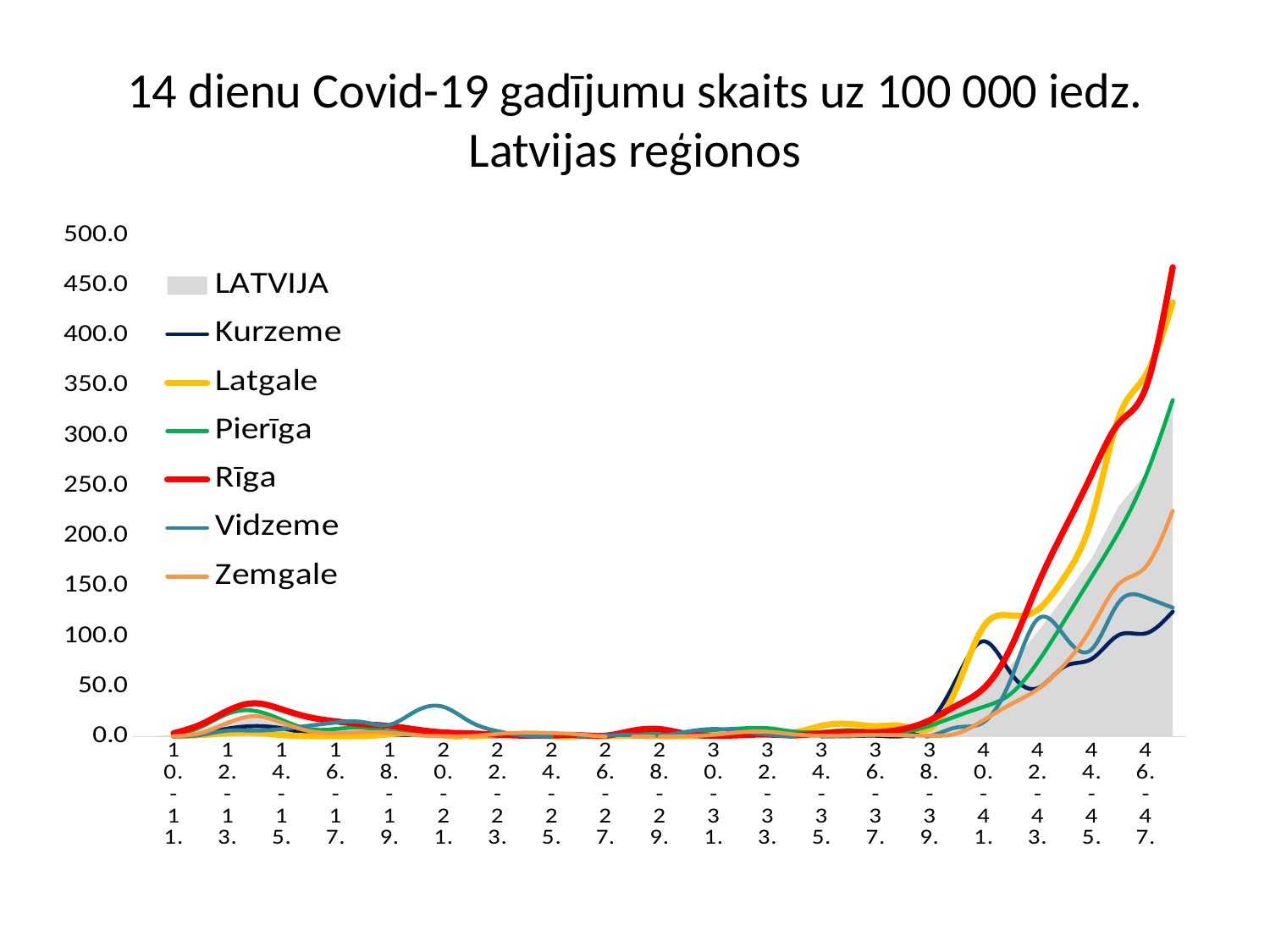
Which series is drawn as a grey shaded area rather than a line? LATVIJA At the right end of the chart, which is larger: Latgale or Zemgale? Latgale How many labels are shown on the x axis? 19 What is the title of the chart? 14 dienu Covid-19 gadījumu skaits uz 100 000 iedz. Latvijas reģionos Is the value for Pierīga at the right end of the chart greater or less than 300? greater What kind of chart is shown on the slide? combination area and line chart Is the value for Zemgale at the right end of the chart greater or less than 250? less How many series does the legend list? 7 Do the values generally rise or fall from left to right along the x axis? rise Is the value for Kurzeme at the right end of the chart greater or less than 150? less Which series has the highest value at the right end of the chart? Rīga